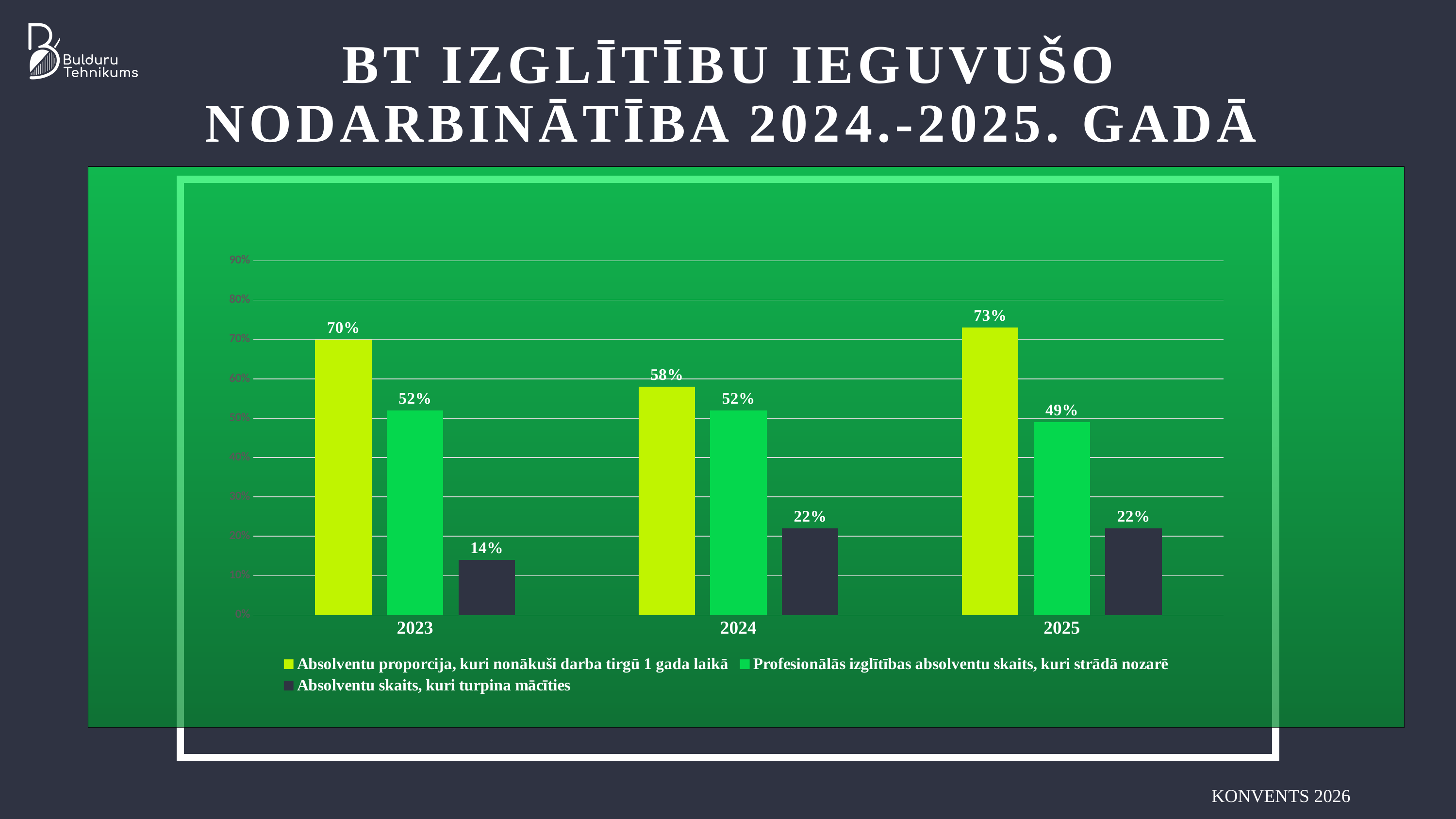
What is the value for 'Absolventu proporcija, kuri nonākuši darba tirgū 1 gada laikā' in 2023? 70% What is the value for 'Absolventu skaits, kuri turpina mācīties' in 2023? 14% What is the value for 'Profesionālās izglītības absolventu skaits, kuri strādā nozarē' in 2025? 49% What kind of chart is shown on the slide? Bar chart Which is larger in 2024: 'Absolventu proporcija, kuri nonākuši darba tirgū 1 gada laikā' or 'Profesionālās izglītības absolventu skaits, kuri strādā nozarē'? Absolventu proporcija, kuri nonākuši darba tirgū 1 gada laikā What is the difference between the 2025 and 2023 values for 'Absolventu proporcija, kuri nonākuši darba tirgū 1 gada laikā'? 3% How many series does the legend list? 3 What is the value for 'Absolventu proporcija, kuri nonākuši darba tirgū 1 gada laikā' in 2024? 58% What is the difference between the 2024 and 2023 values for 'Absolventu skaits, kuri turpina mācīties'? 8% In which year is 'Absolventu proporcija, kuri nonākuši darba tirgū 1 gada laikā' highest? 2025 In which year is 'Absolventu proporcija, kuri nonākuši darba tirgū 1 gada laikā' lowest? 2024 How many years are shown on the x axis? 3